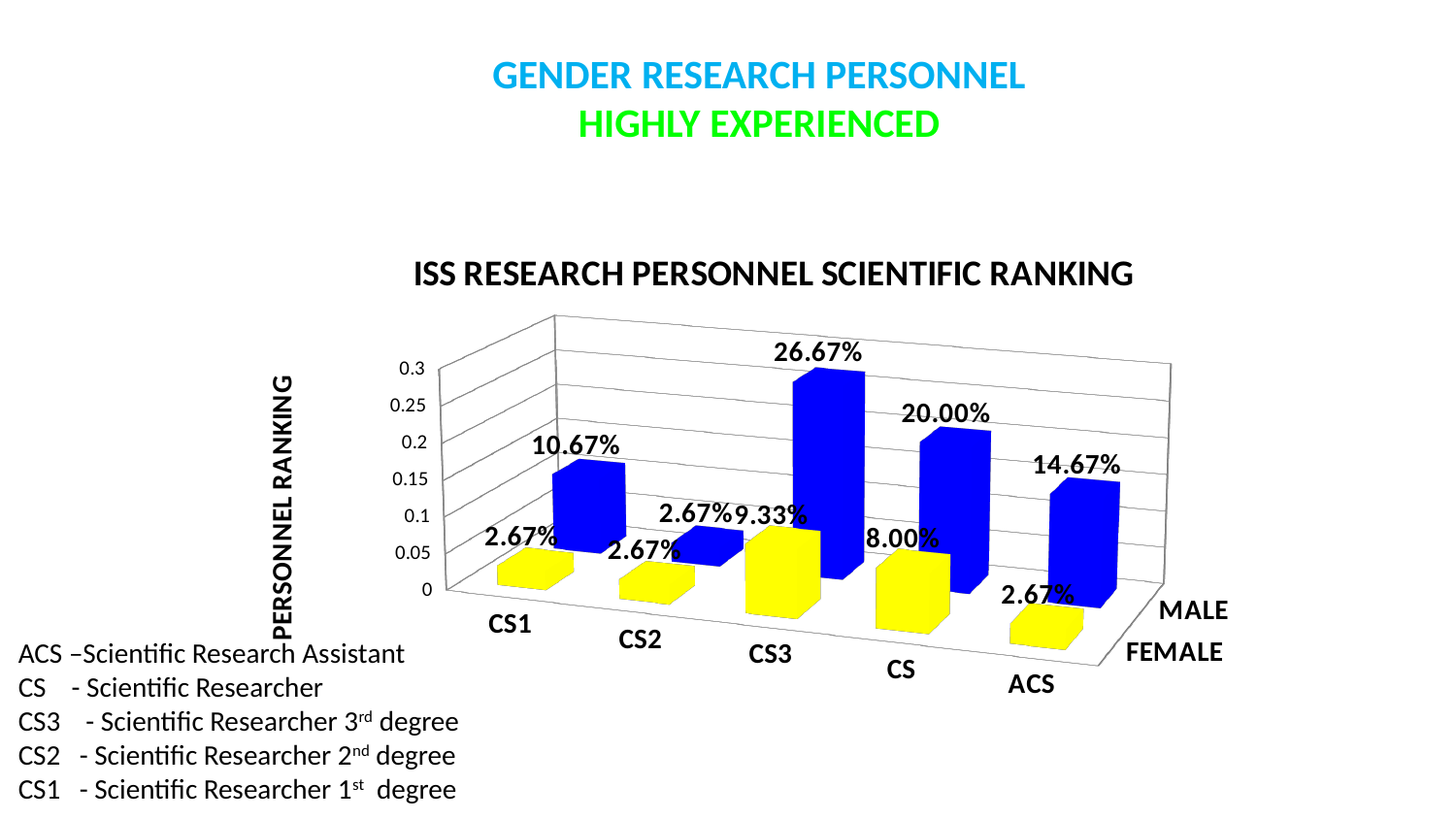
What is the difference between the MALE and FEMALE values for CS in the chart? 12.00% What is the MALE value for ACS in the chart? 14.67% What is the MALE value for CS3 in the ISS RESEARCH PERSONNEL SCIENTIFIC RANKING chart? 26.67% What is the FEMALE value for CS3 in the chart? 9.33% What is the label of the vertical axis of the chart? PERSONNEL RANKING Which category has the highest MALE value in the chart? CS3 Which is larger in the chart: the MALE value for CS1 or the MALE value for ACS? MALE value for ACS Which category has the lowest MALE value in the chart? CS2 What is the FEMALE value for CS in the ISS RESEARCH PERSONNEL SCIENTIFIC RANKING chart? 8.00% What kind of chart is shown on the slide? Bar chart How many categories are shown on the x axis of the chart? 5 How many series does the chart show? 2